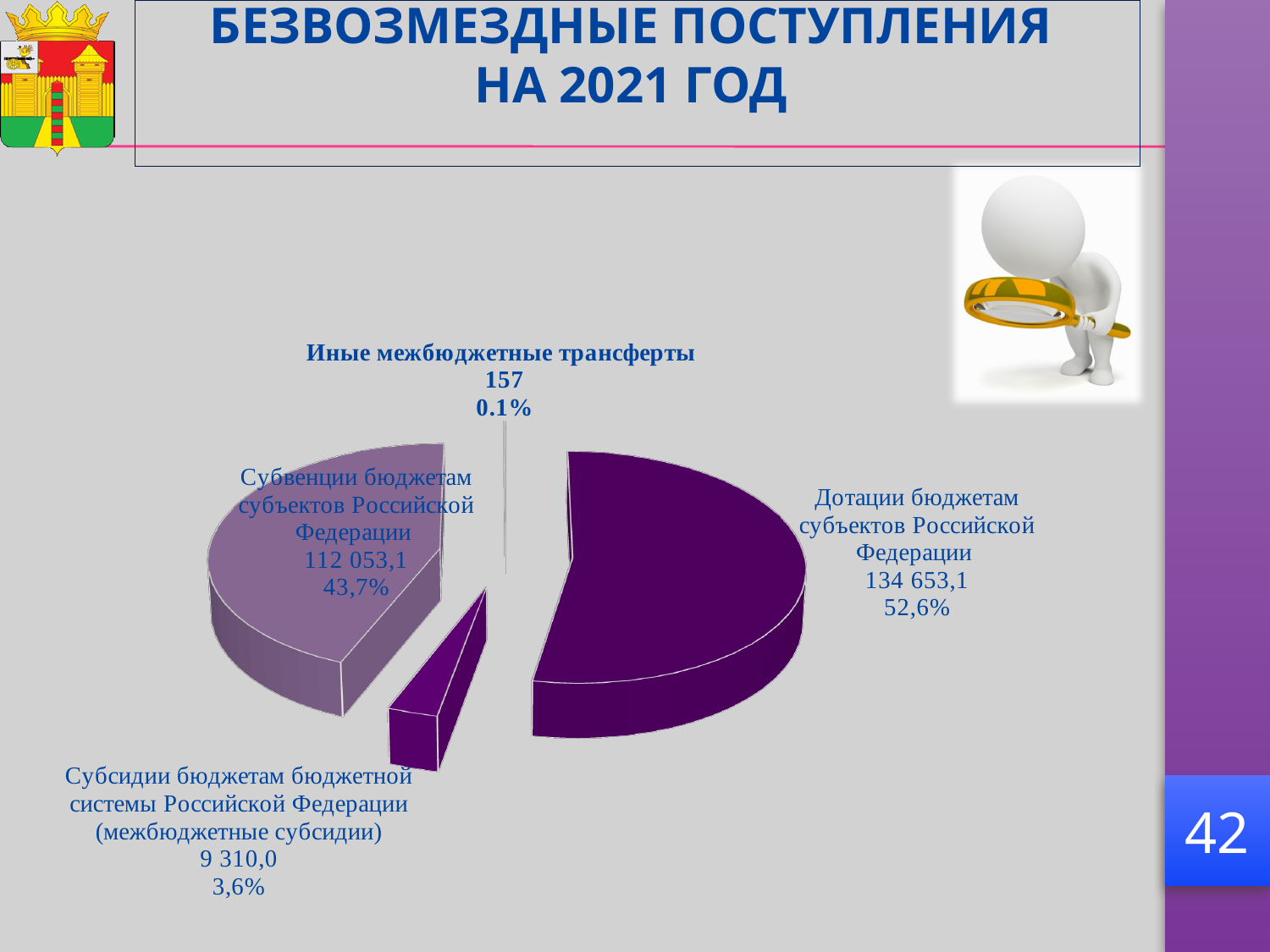
What is the value shown for Субсидии бюджетам бюджетной системы Российской Федерации (межбюджетные субсидии)? 9 310,0 What is the difference between the values for Дотации бюджетам субъектов Российской Федерации and Субвенции бюджетам субъектов Российской Федерации? 22 600,0 Which is larger: the value for Субвенции бюджетам субъектов Российской Федерации or the value for Субсидии бюджетам бюджетной системы Российской Федерации? Субвенции бюджетам субъектов Российской Федерации How many categories are shown in the pie chart? 4 What is the value shown for Иные межбюджетные трансферты? 157 What is the value shown for Дотации бюджетам субъектов Российской Федерации? 134 653,1 What share of the pie does Субсидии бюджетам бюджетной системы Российской Федерации (межбюджетные субсидии) represent? 3,6% Which category has the largest slice of the pie? Дотации бюджетам субъектов Российской Федерации What is the value shown for Субвенции бюджетам субъектов Российской Федерации? 112 053,1 Which category has the smallest slice of the pie? Иные межбюджетные трансферты What share of the pie does Субвенции бюджетам субъектов Российской Федерации represent? 43,7% What kind of chart is shown on the slide? Pie chart